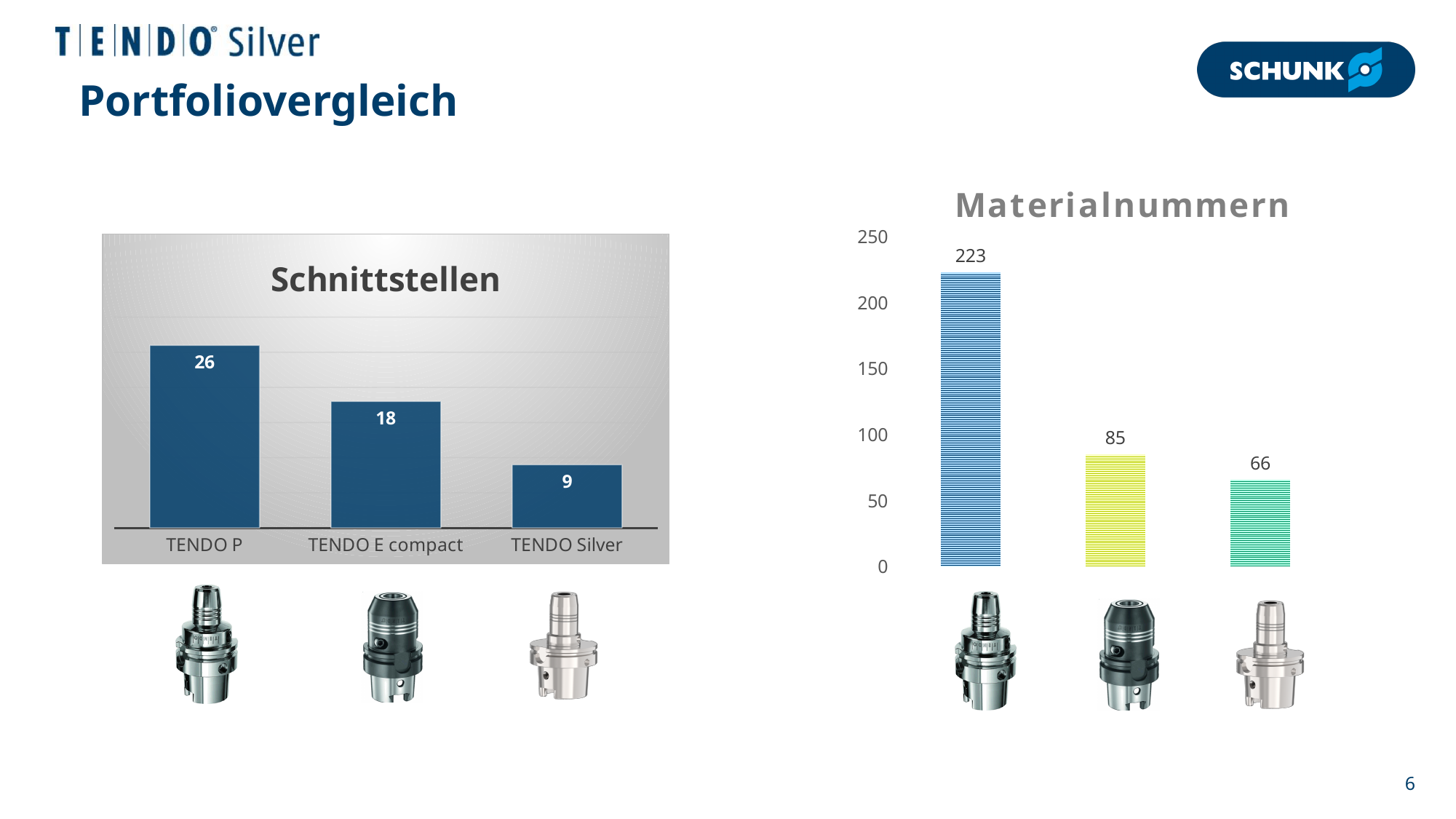
In the Schnittstellen chart, which category has the highest value? TENDO P In the Materialnummern chart, do the values rise or fall from left to right? fall In the Materialnummern chart, what is the value of the third (rightmost) bar? 66 In the Schnittstellen chart, how many categories are shown? 3 In the Materialnummern chart, what is the difference between the first bar and the second bar? 138 In the Schnittstellen chart, what is the value for TENDO P? 26 What kind of chart is the Schnittstellen chart? bar chart In the Schnittstellen chart, what is the difference between TENDO P and TENDO E compact? 8 In the Schnittstellen chart, which category has the lowest value? TENDO Silver In the Materialnummern chart, is the value of the second bar greater or less than 100? less In the Schnittstellen chart, what is the value for TENDO Silver? 9 In the Materialnummern chart, what is the value of the first (leftmost) bar? 223